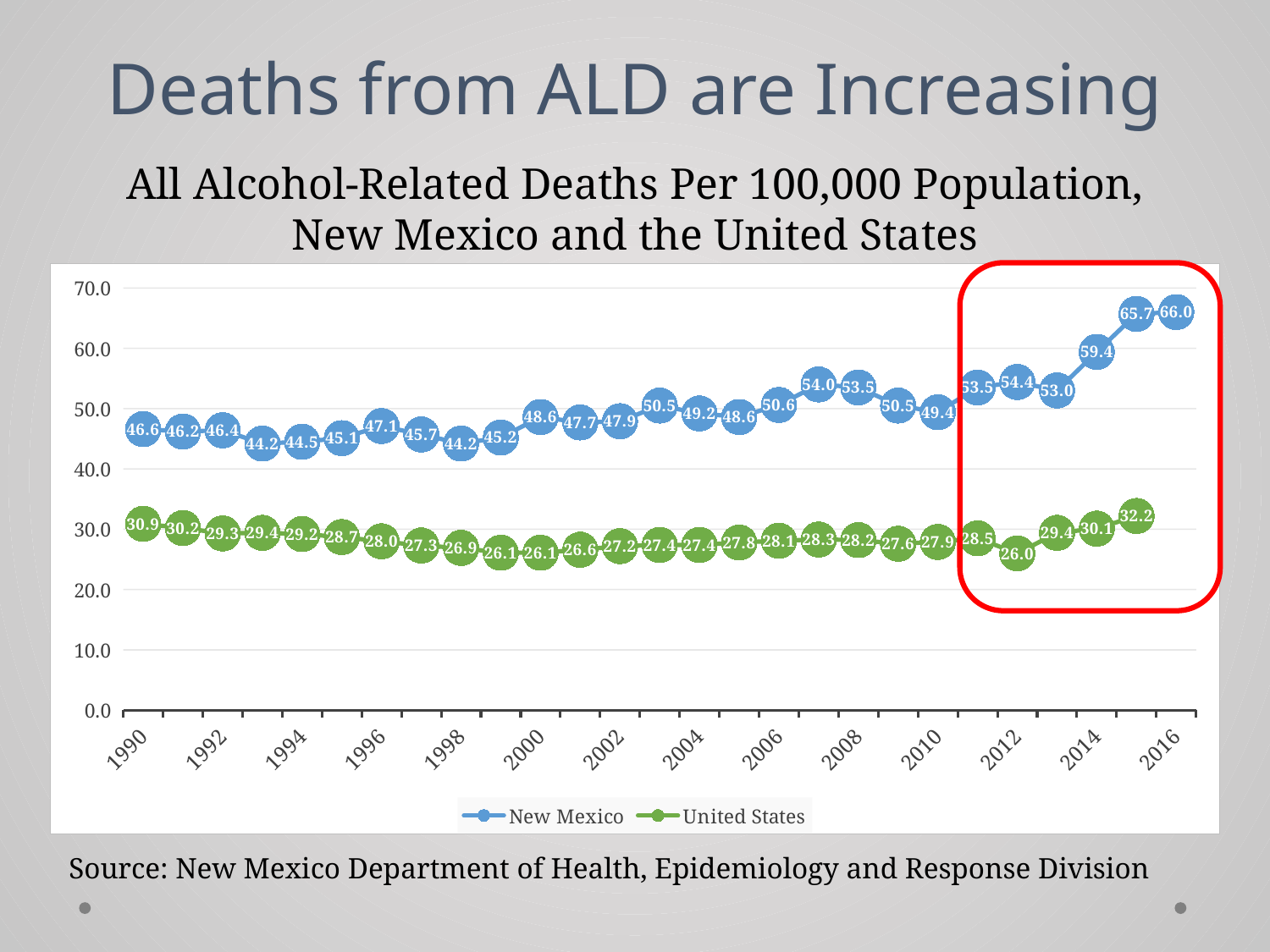
What was the New Mexico alcohol-related death rate per 100,000 in 1990? 46.6 Does the New Mexico series rise or fall between 2013 and 2016? Rise What is the difference between the New Mexico and United States values in 1990? 15.7 What is the lowest value shown for the United States series? 26.0 What type of chart is shown on the slide? Line chart What was the United States alcohol-related death rate per 100,000 in 1990? 30.9 Which series has the higher value in 2014, New Mexico or United States? New Mexico In which year did the New Mexico series reach its highest value? 2016 By how much did the New Mexico rate increase from 1990 to 2016? 19.4 What was the New Mexico value in 2016? 66.0 How many series does the legend list? 2